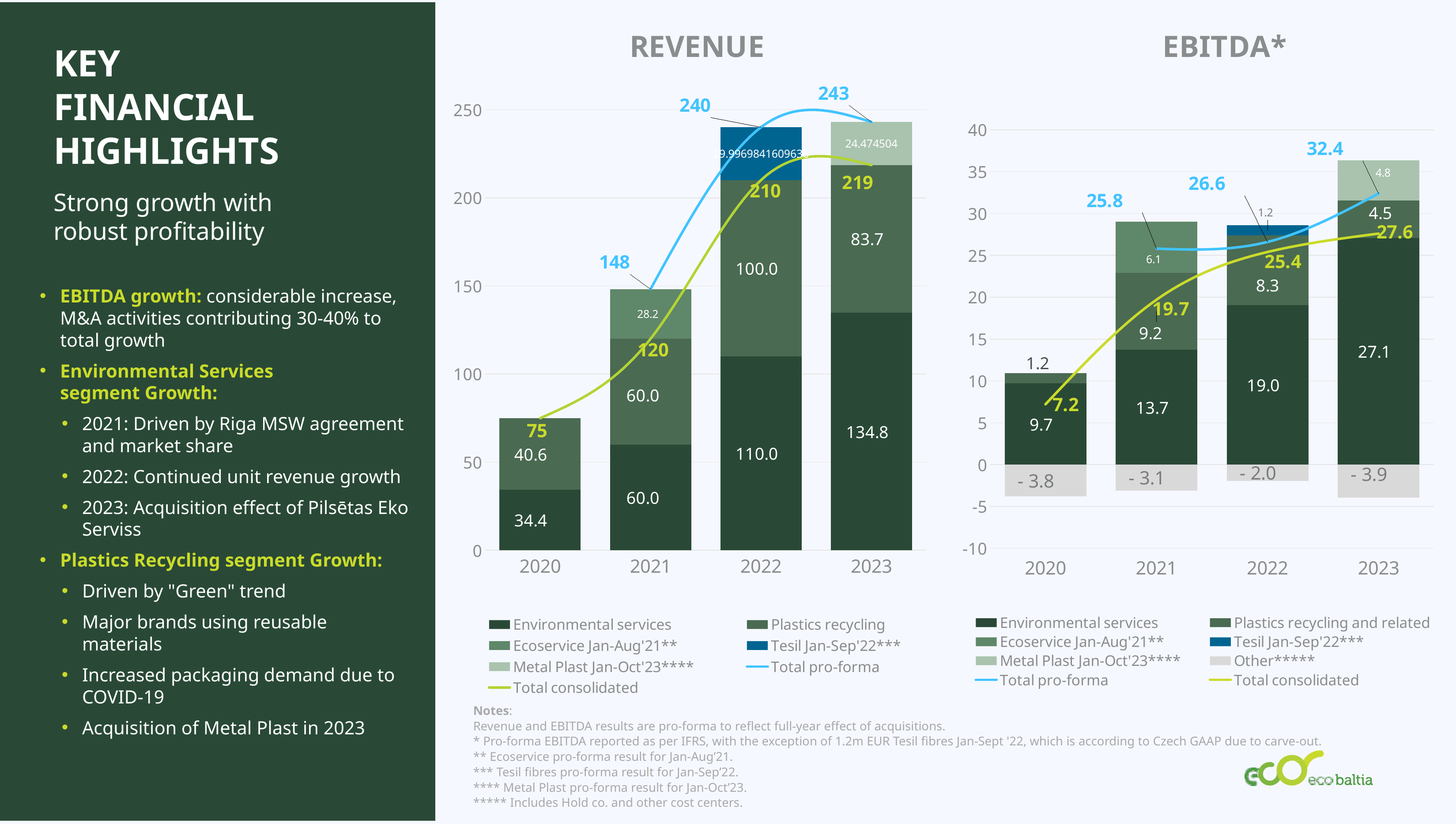
In the REVENUE chart, what is the difference between the Plastics recycling values for 2022 and 2023? 16.3 In the EBITDA* chart, what is the Other value for 2023? - 3.9 In the REVENUE chart, what is the Environmental services value for 2023? 134.8 In the EBITDA* chart, what is the Total pro-forma value for 2021? 25.8 In the REVENUE chart, how many entries does the legend list? 7 In the EBITDA* chart, is the Plastics recycling and related value for 2021 larger or smaller than for 2023? larger What kind of chart is the REVENUE chart? Stacked bar chart with lines In the EBITDA* chart, what is the Environmental services value for 2022? 19.0 In the REVENUE chart, which year has the highest Environmental services value? 2023 In the EBITDA* chart, which year has the lowest Total consolidated value? 2020 In the REVENUE chart, what is the Total consolidated value for 2020? 75 In the REVENUE chart, what is the Total pro-forma value for 2022? 240